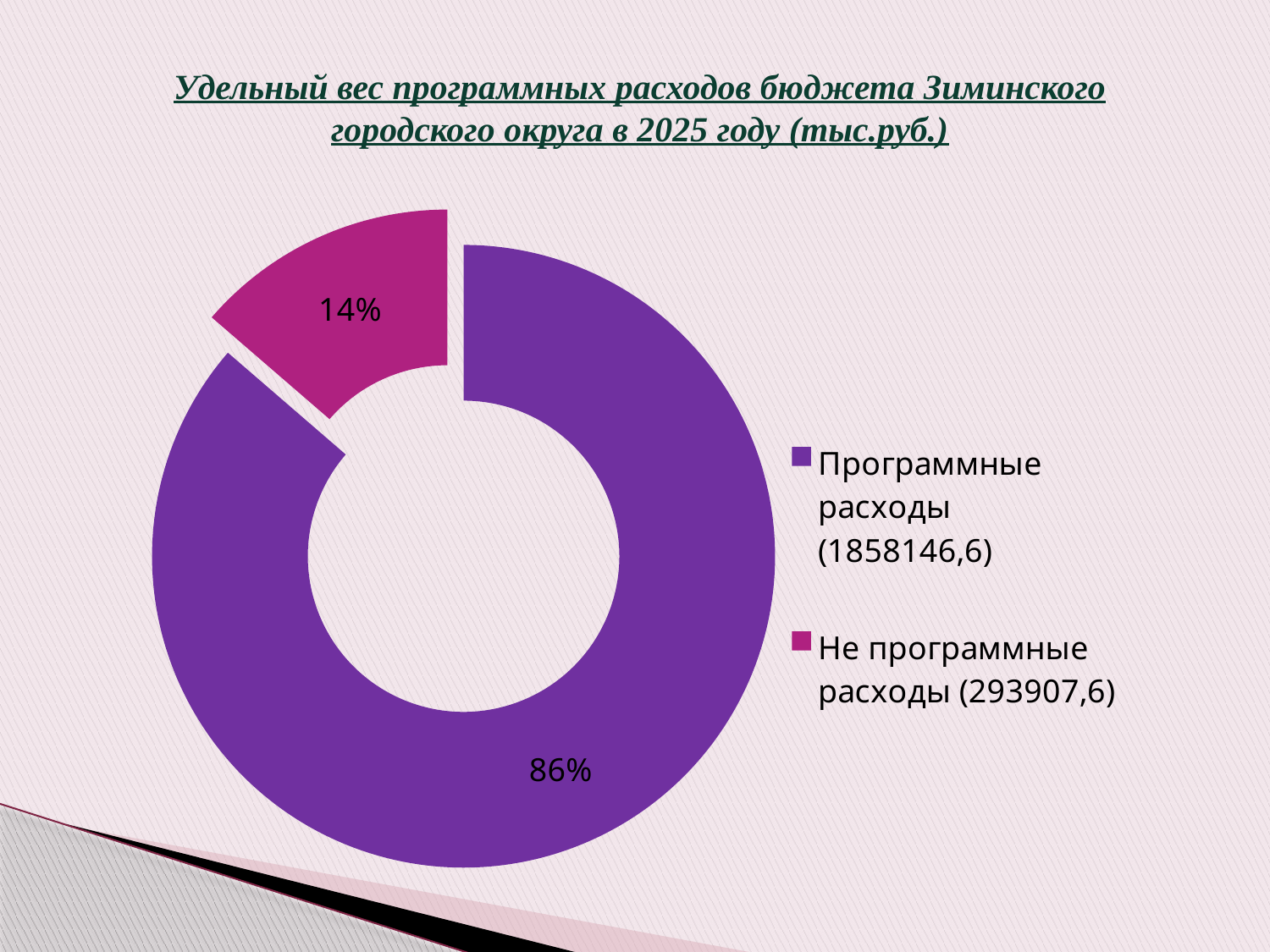
What share of the pie does "Не программные расходы" take? 14% How many slices does the pie chart have? 2 What value is given for "Программные расходы" in the legend? 1858146,6 What share of the pie does "Программные расходы" take? 86% Which category has the smallest slice of the pie? Не программные расходы Which category has the largest slice of the pie? Программные расходы By how many percentage points does the share of "Программные расходы" exceed the share of "Не программные расходы"? 72 percentage points What kind of chart is shown on the slide? Pie chart (doughnut) What value is given for "Не программные расходы" in the legend? 293907,6 Which is larger: the share of "Программные расходы" or the share of "Не программные расходы"? Программные расходы How many entries does the legend list? 2 What is the title of the chart on the slide? Удельный вес программных расходов бюджета Зиминского городского округа в 2025 году (тыс.руб.)